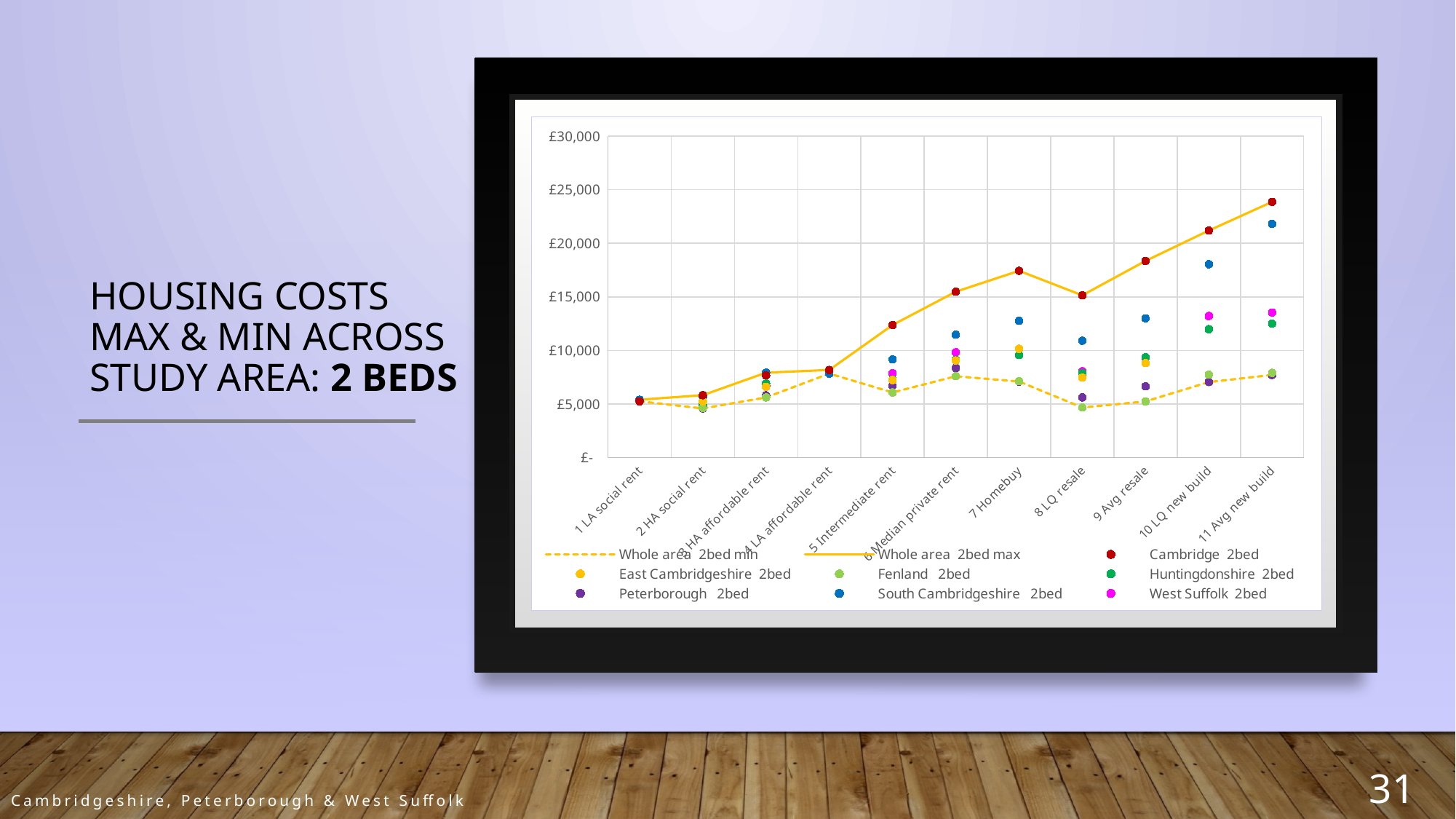
Is the value for Peterborough 2bed at 8 LQ resale greater or less than £10,000? less How many series does the chart's legend list? 9 Is the value for West Suffolk 2bed at 10 LQ new build greater or less than £10,000? greater Is the value for Whole area 2bed max at 5 Intermediate rent greater or less than £10,000? greater What kind of chart is shown on the slide? line chart At which category does the Whole area 2bed max series reach its highest value? 11 Avg new build Does the Whole area 2bed max series rise or fall from 8 LQ resale to 11 Avg new build? rise How many categories are shown along the x axis of the chart? 11 Which legend entry is drawn as a dashed line? Whole area 2bed min At 11 Avg new build, which is higher: Cambridge 2bed or South Cambridgeshire 2bed? Cambridge 2bed